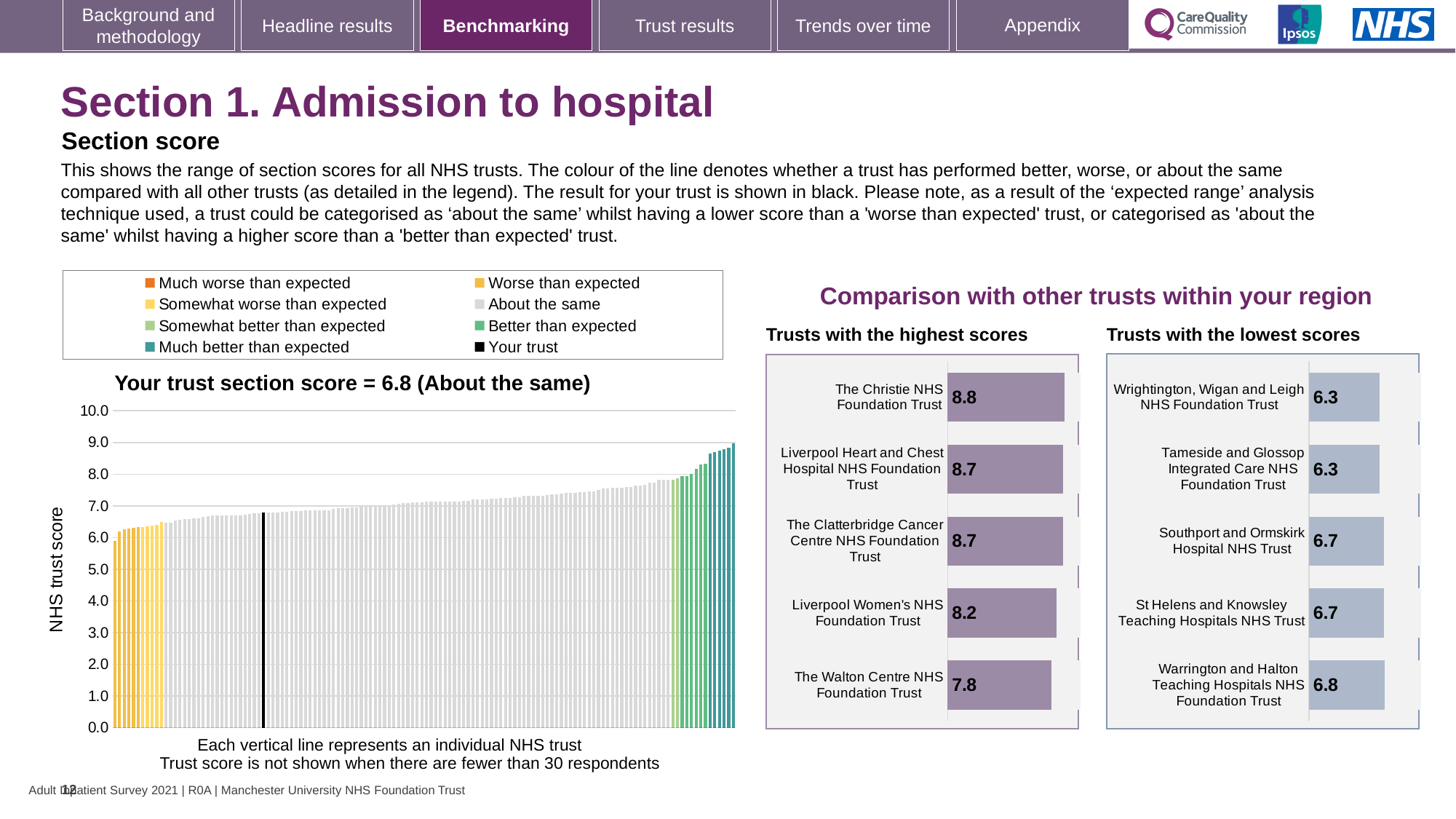
On the 'Trusts with the highest scores' chart, which trust has the lowest score? The Walton Centre NHS Foundation Trust On the 'Your trust section score' chart, what is the section score for your trust? 6.8 On the 'Trusts with the highest scores' chart, what is the difference between the scores of The Christie NHS Foundation Trust and The Walton Centre NHS Foundation Trust? 1.0 On the 'Your trust section score' chart, what is the label on the vertical axis? NHS trust score On the 'Trusts with the lowest scores' chart, what is the score for Southport and Ormskirk Hospital NHS Trust? 6.7 On the 'Your trust section score' chart, what kind of chart is shown? bar chart On the 'Your trust section score' chart, do the trust scores rise or fall from left to right? rise On the 'Trusts with the highest scores' chart, how many trusts are shown? 5 On the 'Trusts with the lowest scores' chart, which trust has the highest score? Warrington and Halton Teaching Hospitals NHS Foundation Trust On the 'Trusts with the highest scores' chart, what is the score for The Christie NHS Foundation Trust? 8.8 On the 'Trusts with the lowest scores' chart, which has the larger score: Southport and Ormskirk Hospital NHS Trust or Wrightington, Wigan and Leigh NHS Foundation Trust? Southport and Ormskirk Hospital NHS Trust On the 'Your trust section score' chart, how many entries does the legend list? 8